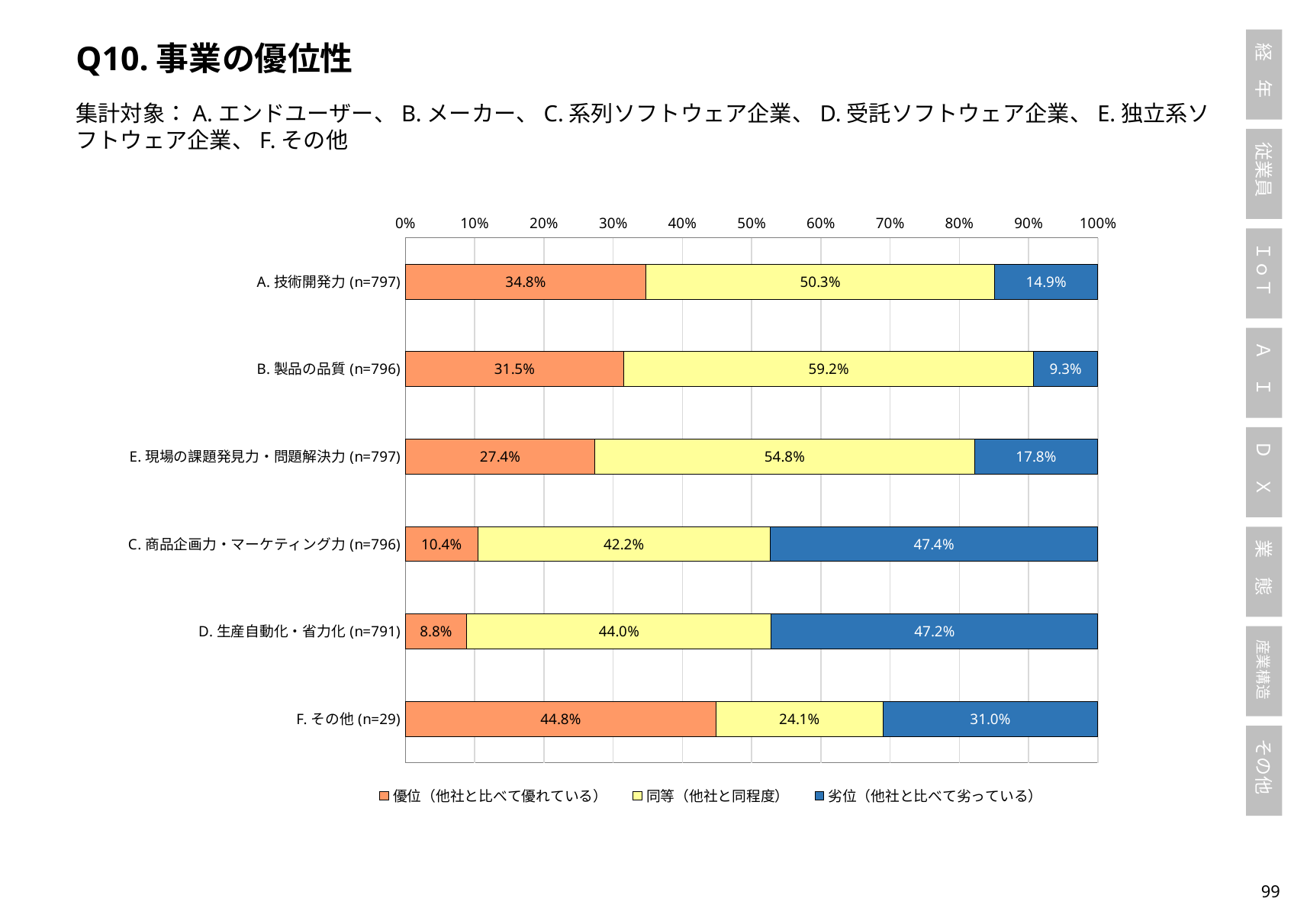
What is the difference between the 同等 values for E. 現場の課題発見力・問題解決力 (n=797) and F. その他 (n=29)? 30.7% Which category has the lowest 劣位 (他社と比べて劣っている) value? B. 製品の品質 (n=796) How many categories are plotted on the chart? 6 How many series does the legend list? 3 What is the 同等 (他社と同程度) value for B. 製品の品質 (n=796)? 59.2% What is the 優位 (他社と比べて優れている) value for D. 生産自動化・省力化 (n=791)? 8.8% What colour represents the 劣位 (他社と比べて劣っている) series? Blue What is the 優位 (他社と比べて優れている) value for A. 技術開発力 (n=797)? 34.8% What is the 劣位 (他社と比べて劣っている) value for C. 商品企画力・マーケティング力 (n=796)? 47.4% Which category has the highest 優位 (他社と比べて優れている) value? F. その他 (n=29) Which is larger: the 優位 value for A. 技術開発力 (n=797) or the 優位 value for B. 製品の品質 (n=796)? A. 技術開発力 (n=797) What type of chart is shown on the slide? Stacked bar chart